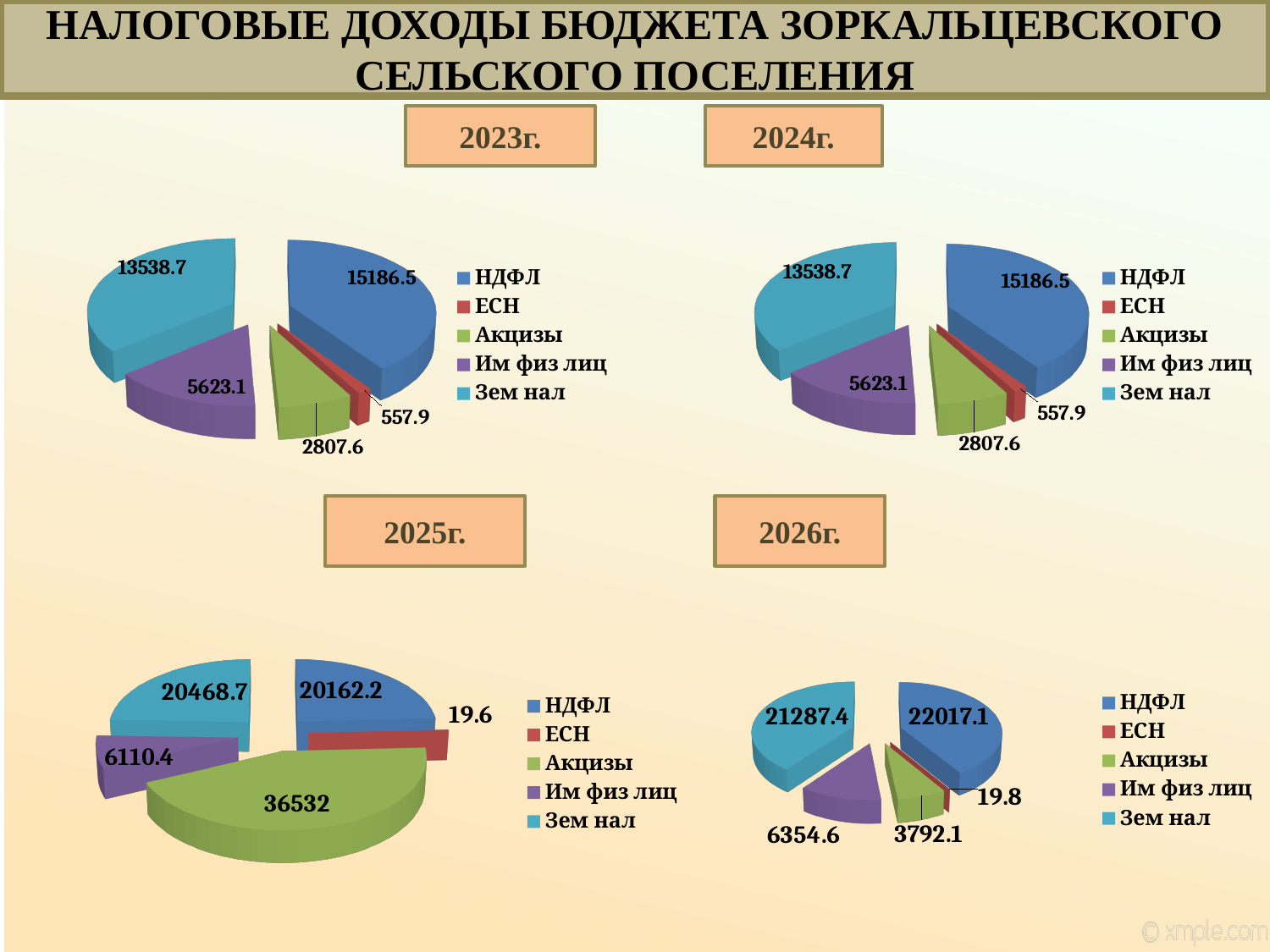
What type of chart is used for 2025г.? Pie chart In the 2023г. pie chart, what is the value for НДФЛ? 15186.5 In the 2024г. pie chart, which is larger: Им физ лиц or Акцизы? Им физ лиц In the 2026г. pie chart, what is the difference between the values for НДФЛ and Зем нал? 729.7 In the 2025г. pie chart, what is the difference between the values for Акцизы and НДФЛ? 16369.8 In the 2025г. pie chart, what is the value for Им физ лиц? 6110.4 In the 2024г. pie chart, what is the value for Акцизы? 2807.6 In the 2023г. pie chart, which category has the largest value? НДФЛ In the 2026г. pie chart, which category has the smallest value? ЕСН In the 2025г. pie chart, which category has the largest value? Акцизы In the 2026г. pie chart, what is the value for Зем нал? 21287.4 How many slices does the 2026г. pie chart have? 5